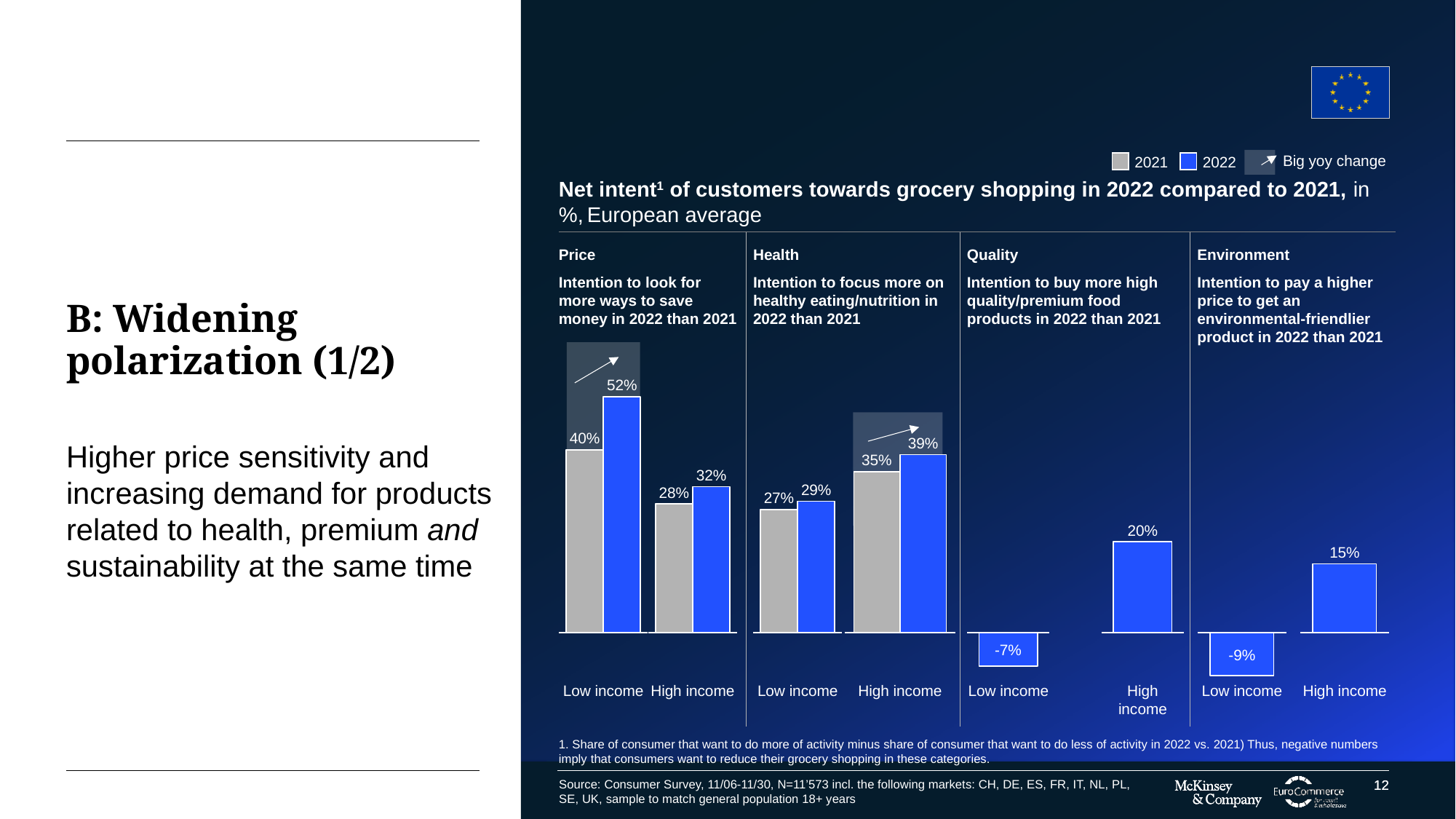
What kind of chart is used in the Price panel? Bar chart In the Price chart, what is the difference between the 2022 and 2021 values for Low income? 12 percentage points In the Price chart, what is the 2021 value for High income? 28% In the Health chart, what is the 2022 value for High income? 39% In the Environment chart, what is the value for High income? 15% In the Price chart, what is the 2022 value for Low income? 52% In the Quality chart, which income group has the higher value? High income In the Health chart, which is larger: the 2021 value for High income or the 2022 value for Low income? 2021 value for High income How many years does the legend list? 2 In the Quality chart, what is the value for Low income? -7% In the Environment chart, which income group has the lowest value? Low income In the Health chart, what is the difference between the 2022 and 2021 values for Low income? 2 percentage points